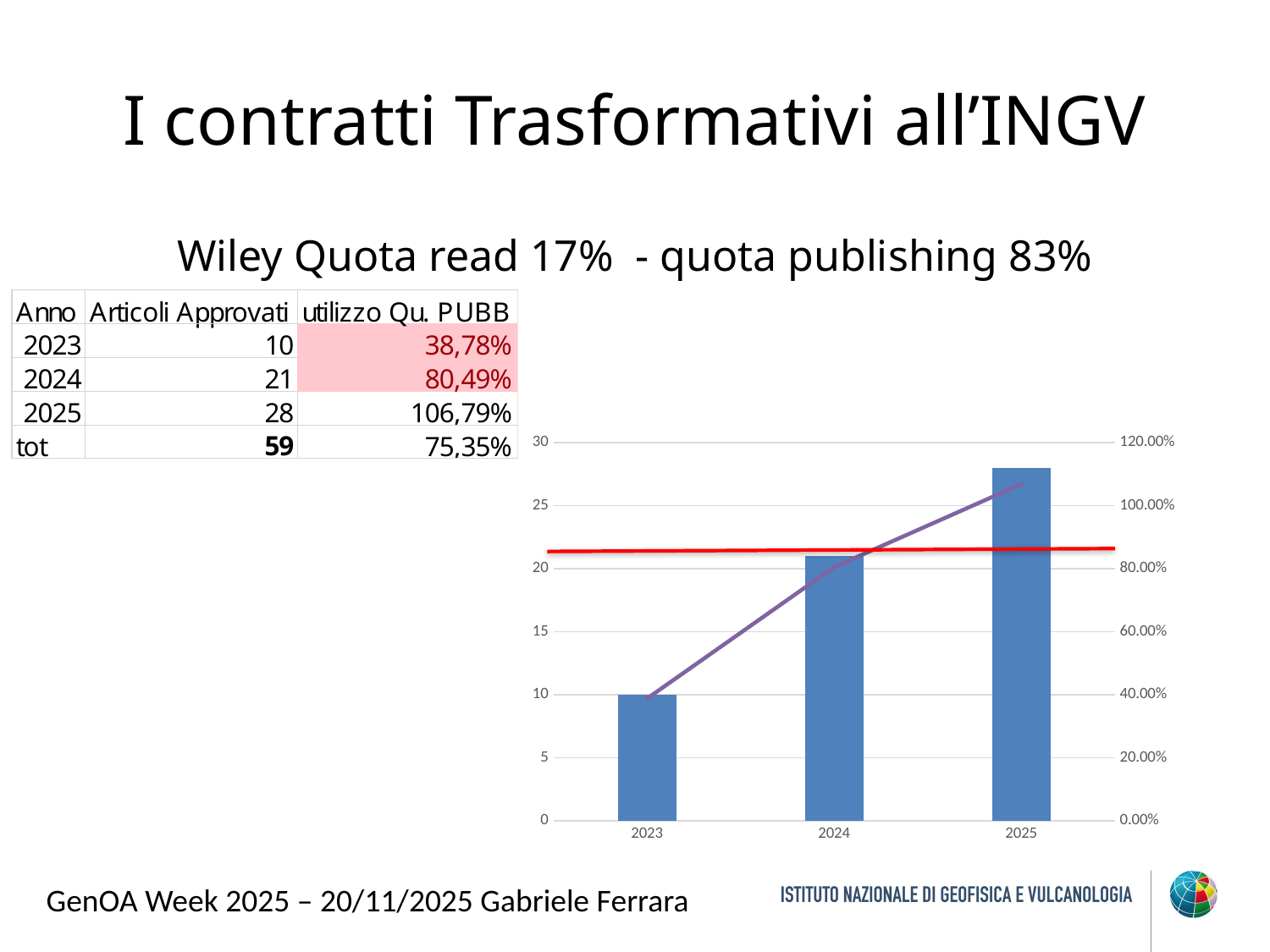
Is the bar for 2024 greater or less than 20 on the left axis? greater Is the purple line value for 2025 greater or less than 100.00% on the right axis? greater Which year has the tallest bar in the chart? 2025 Do the bar values rise or fall from 2023 to 2025? rise What is the difference between the bar values for 2025 and 2023? 18 What kind of chart is shown on the slide? bar chart with line How many years are shown on the x axis of the chart? 3 According to the table, how many articles were approved in 2025? 28 Is the bar for 2025 greater or less than 25 on the left axis? greater What is the bar value for 2023 in the chart? 10 According to the table, how many articles were approved in 2024? 21 Which year has the shortest bar in the chart? 2023